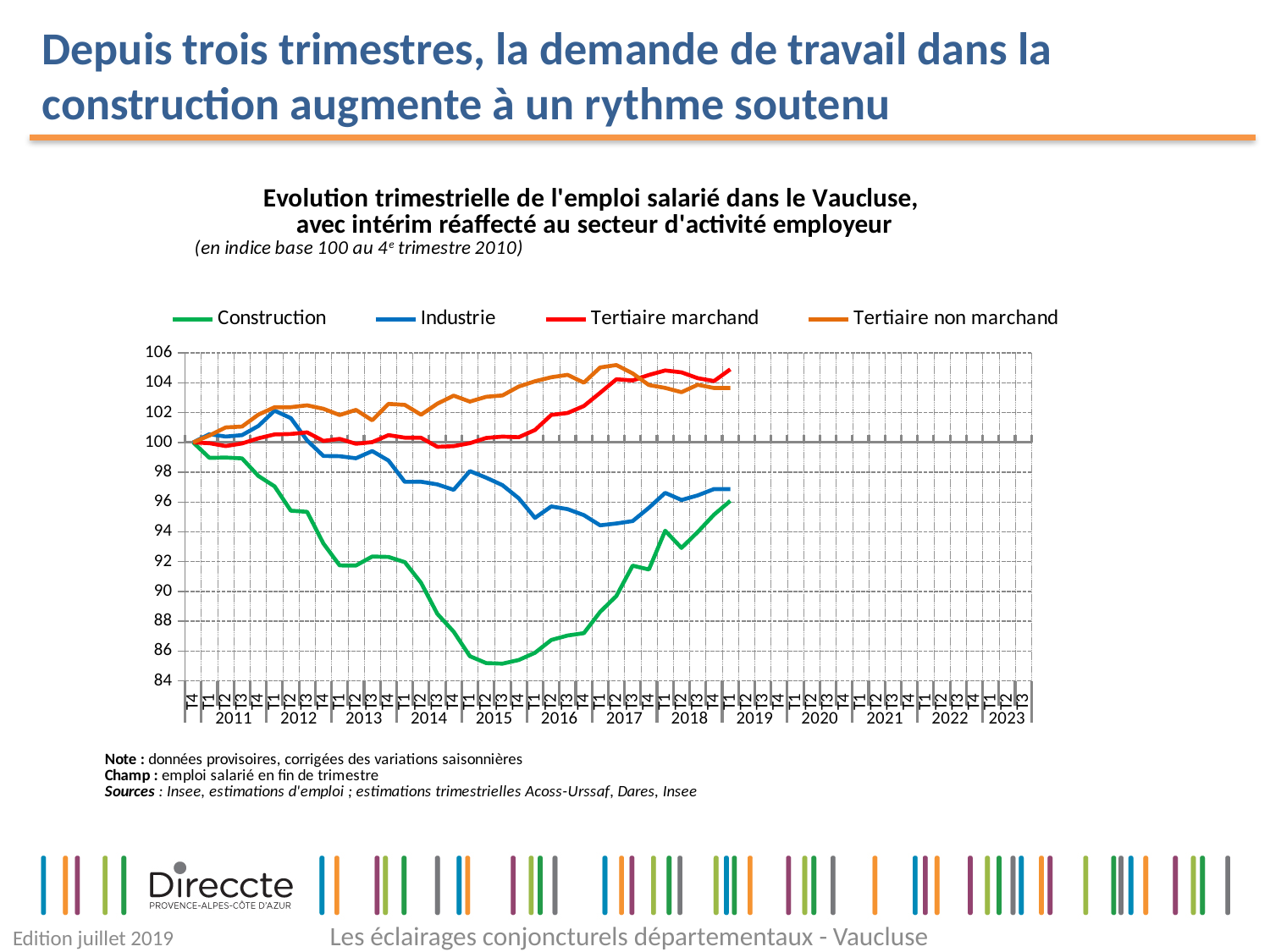
Which series has the lowest value at T1 2015? Construction Is the value for Tertiaire non marchand at T1 2017 greater or less than 104? greater How many series does the legend list? 4 Is the value for Construction at T1 2014 greater or less than 94? less Which series has the highest value at T1 2017? Tertiaire non marchand What is the index value of all four series at T4 2010, the base quarter? 100 What kind of chart is shown on the slide? line chart Which series is drawn in green? Construction At T1 2019, which is higher: Tertiaire marchand or Tertiaire non marchand? Tertiaire marchand Does the Construction series rise or fall between T4 2010 and T1 2015? fall Is the value for Construction at T1 2015 greater or less than 86? less